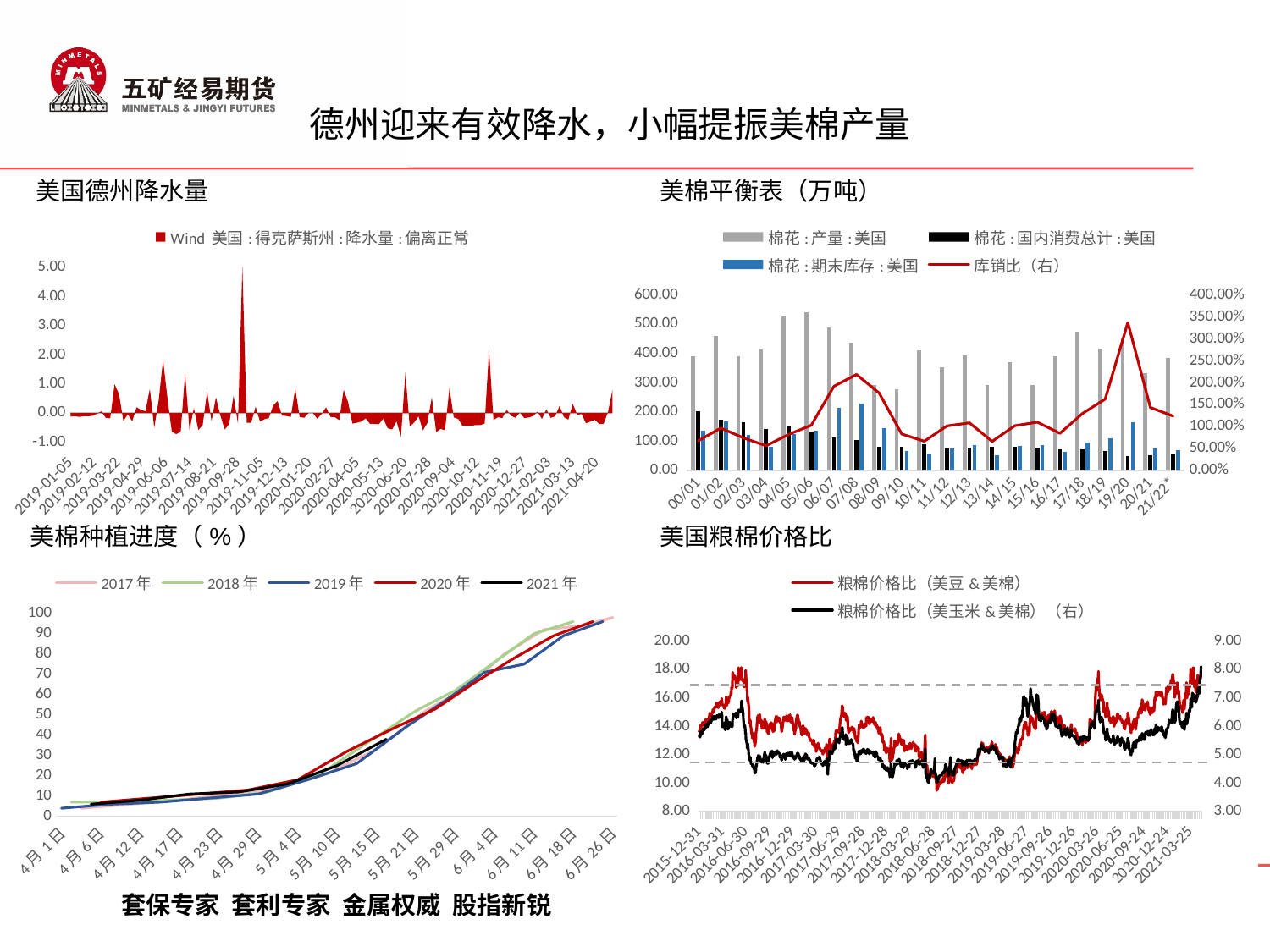
In the 美国德州降水量 chart, is the peak value around 2019-09-28 greater or less than 4.00? greater How many series does the legend of the 美棉种植进度（%） chart list? 5 How many series does the legend of the 美国粮棉价格比 chart list? 2 In the 美棉平衡表（万吨） chart, which is larger for 00/01: 棉花:产量:美国 or 棉花:国内消费总计:美国? 棉花:产量:美国 In the 美棉平衡表（万吨） chart, which season has the highest 库销比? 19/20 In the 美棉种植进度（%） chart, do the values rise or fall from 4月1日 to 6月26日? Rise In the 美国粮棉价格比 chart, which series is plotted on the right axis? 粮棉价格比（美玉米&美棉） What kind of chart is the 美棉种植进度（%） chart? Line chart How many seasons are shown on the x axis of the 美棉平衡表（万吨） chart? 22 How many series does the legend of the 美棉平衡表（万吨） chart list? 4 In the 美棉平衡表（万吨） chart, is the 库销比 for 19/20 greater or less than 300.00%? greater In the 美棉平衡表（万吨） chart, is the 棉花:产量:美国 value for 05/06 greater or less than 500.00? greater